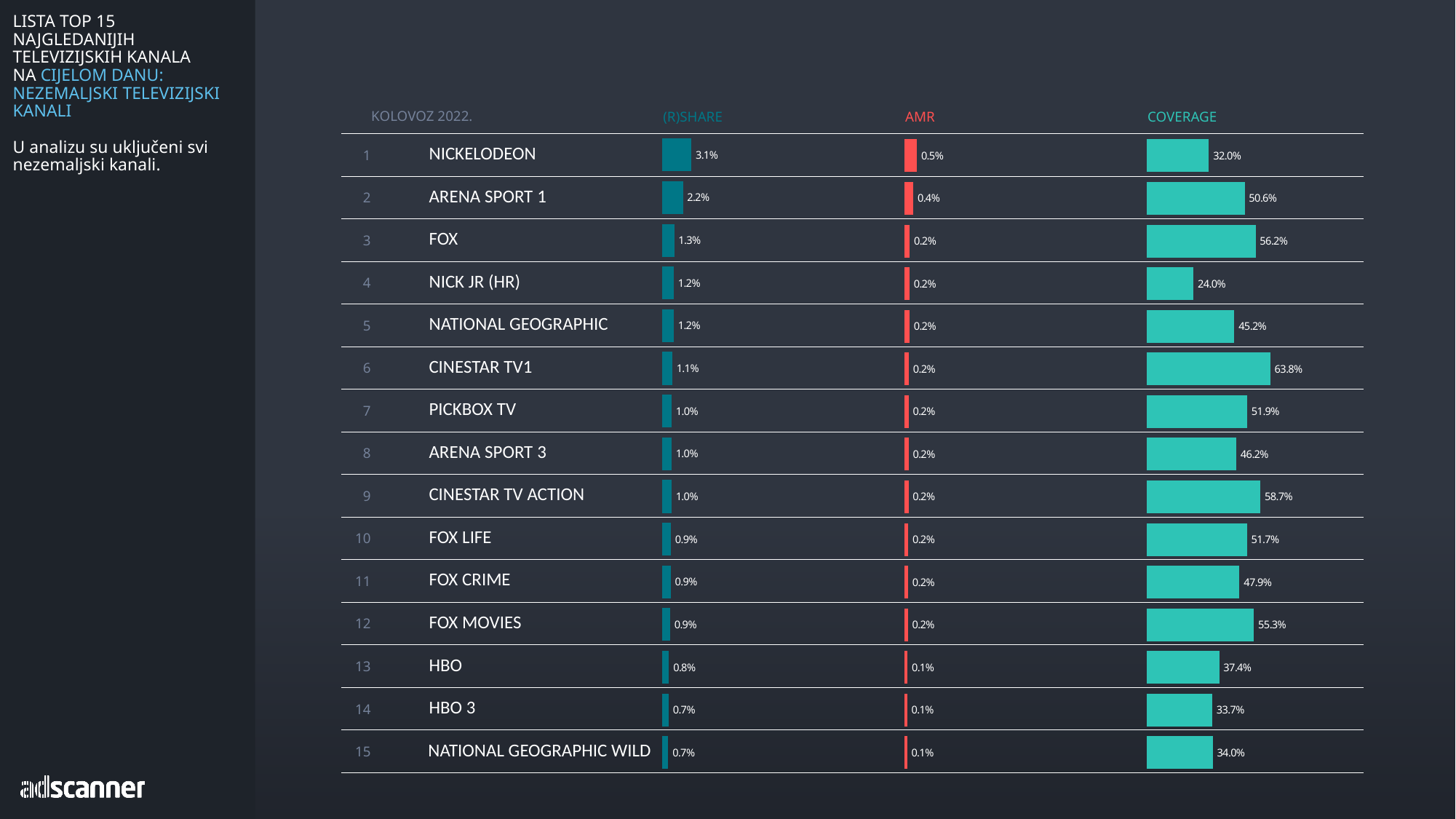
Which month and year do the charts on the slide refer to? KOLOVOZ 2022. In the AMR chart, what is the value for ARENA SPORT 1? 0.4% In the COVERAGE chart, what is the difference between FOX and NICKELODEON? 24.2% What kind of chart is used for the (R)SHARE, AMR and COVERAGE columns? Bar chart In the COVERAGE chart, what is the value for CINESTAR TV ACTION? 58.7% In the COVERAGE chart, which channel has the lowest value? NICK JR (HR) In the COVERAGE chart, which channel has the highest value? CINESTAR TV1 In the (R)SHARE chart, what is the difference between NICKELODEON and ARENA SPORT 1? 0.9% In the (R)SHARE chart, which channel has the highest value? NICKELODEON How many channels are listed in the charts on the slide? 15 In the (R)SHARE chart, what is the value for NICKELODEON? 3.1% In the COVERAGE chart, which is larger: HBO or FOX MOVIES? FOX MOVIES